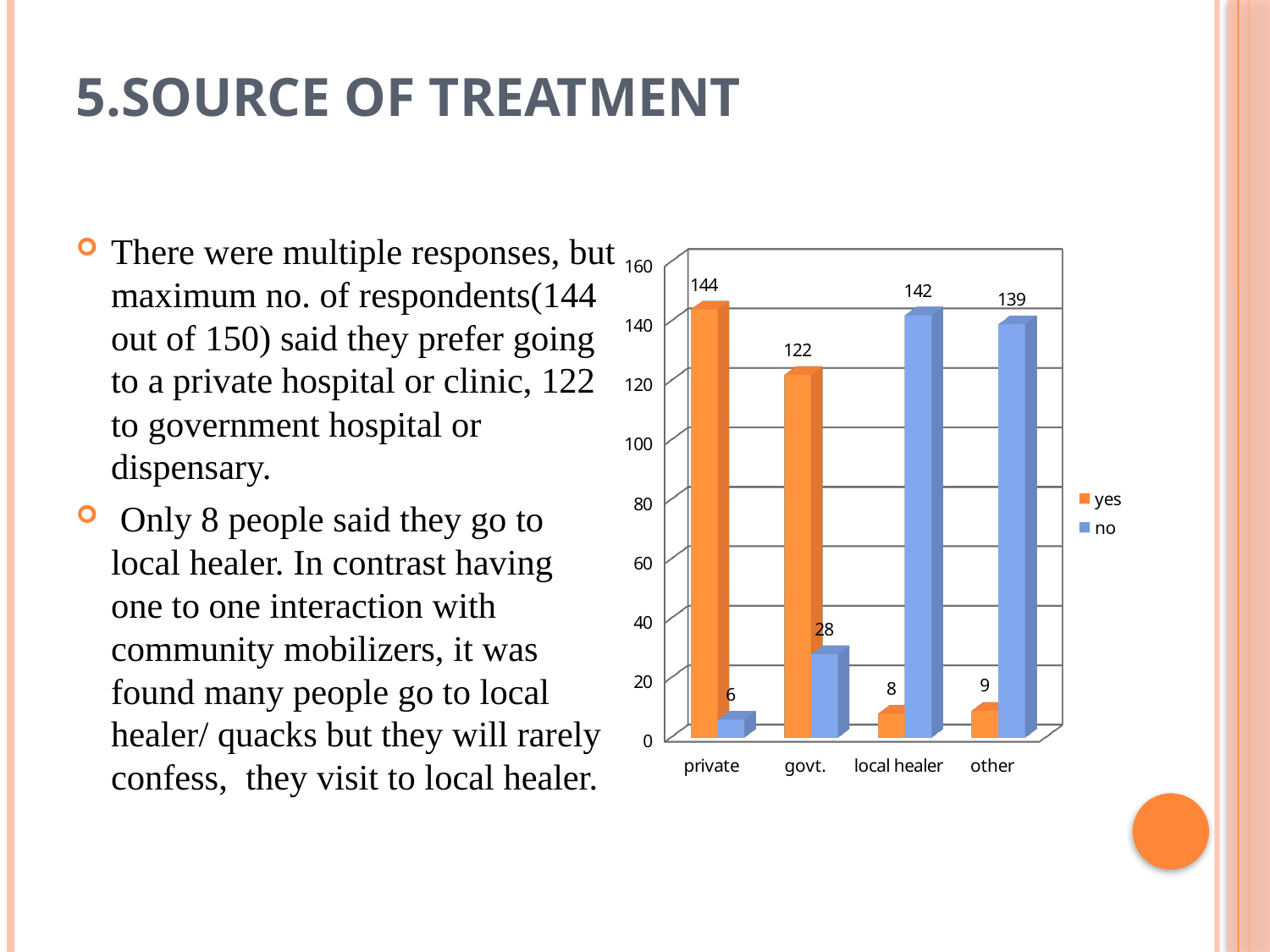
What is the 'yes' value for private? 144 What is the difference between the 'yes' values for private and govt.? 22 Which is larger: the 'no' value for local healer or the 'no' value for other? local healer How many series does the legend list? 2 Which category has the highest 'yes' value? private Which category has the lowest 'no' value? private Which colour represents the 'no' series in the chart? blue How many categories are shown on the x axis? 4 What is the 'no' value for other? 139 What is the 'no' value for govt.? 28 What is the 'yes' value for local healer? 8 What kind of chart is shown on the slide? bar chart